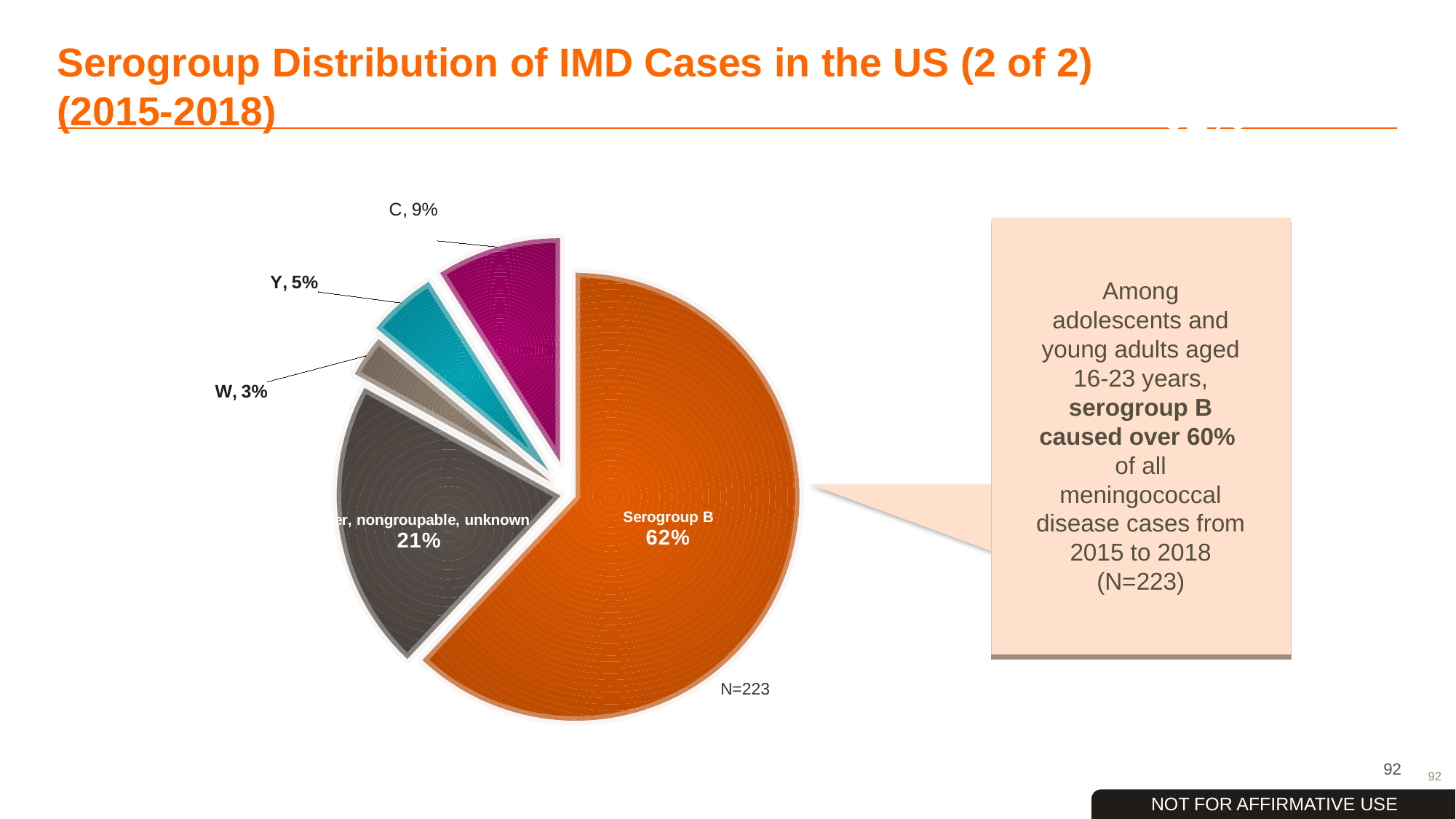
Which slice of the pie chart is the largest? Serogroup B What percentage does serogroup C account for in the pie chart? 9% What percentage does serogroup W account for in the pie chart? 3% How many slices does the pie chart have? 5 What type of chart is shown on the slide? Pie chart What is the total number of cases (N) noted on the pie chart? N=223 How many percentage points larger is the Serogroup B slice than the 'nongroupable, unknown' slice? 41 percentage points Which serogroup has the smallest slice in the pie chart? W What percentage is shown for the 'nongroupable, unknown' slice of the pie chart? 21% Which slice is larger in the pie chart, serogroup C or serogroup Y? C What percentage of IMD cases is attributed to Serogroup B in the pie chart? 62% What percentage does serogroup Y account for in the pie chart? 5%